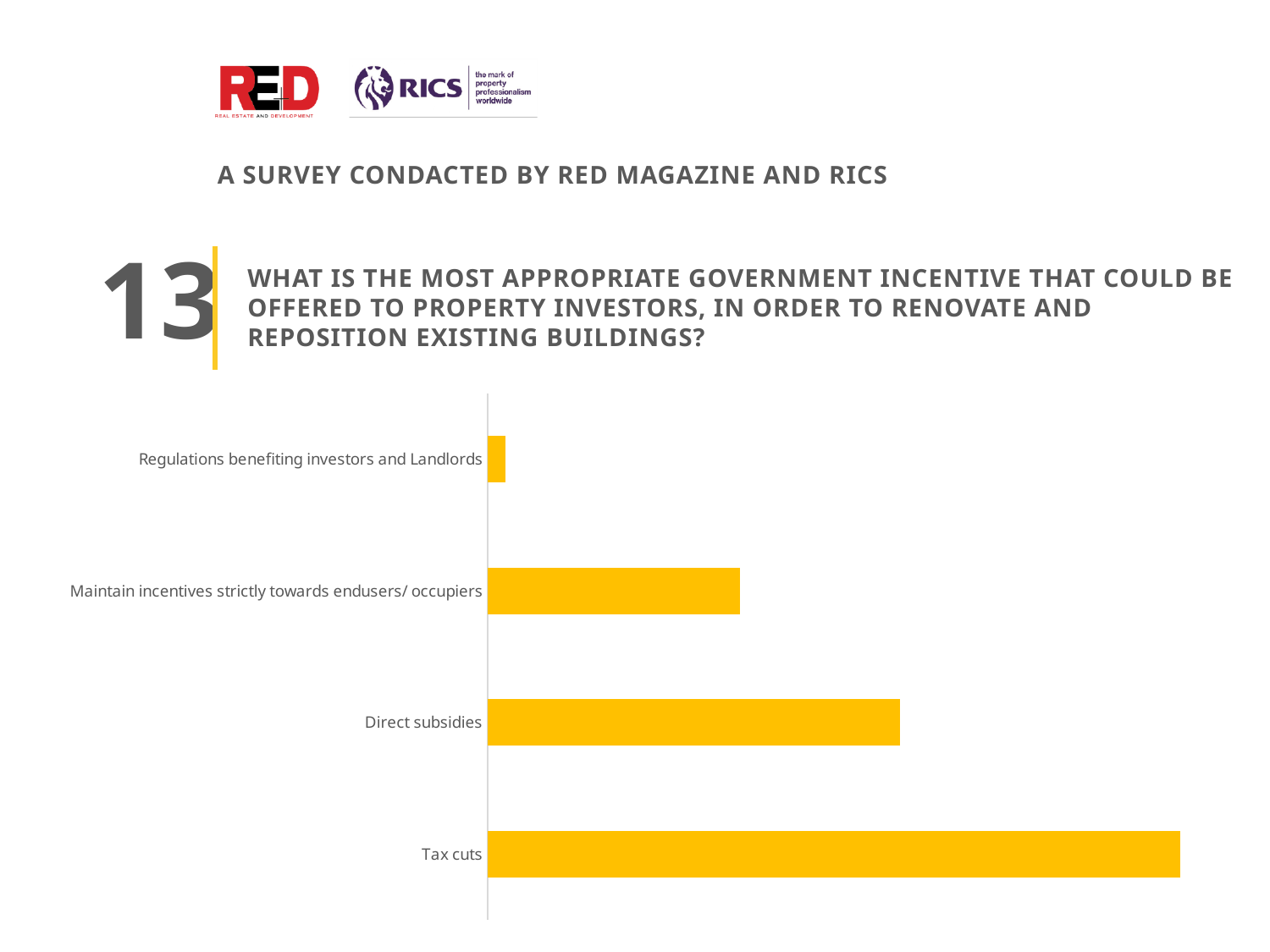
What kind of chart is shown on the slide? Bar chart Which has the larger value: Direct subsidies or Maintain incentives strictly towards endusers/ occupiers? Direct subsidies Which category has the shortest bar in the chart? Regulations benefiting investors and Landlords Which category has the longest bar in the chart? Tax cuts Are the bars in the chart horizontal or vertical? Horizontal What colour are the bars in the chart? Yellow Which has the smaller value: Regulations benefiting investors and Landlords or Maintain incentives strictly towards endusers/ occupiers? Regulations benefiting investors and Landlords How many categories are plotted in the chart? 4 Which has the larger value: Tax cuts or Direct subsidies? Tax cuts Which category is the second highest in the chart? Direct subsidies